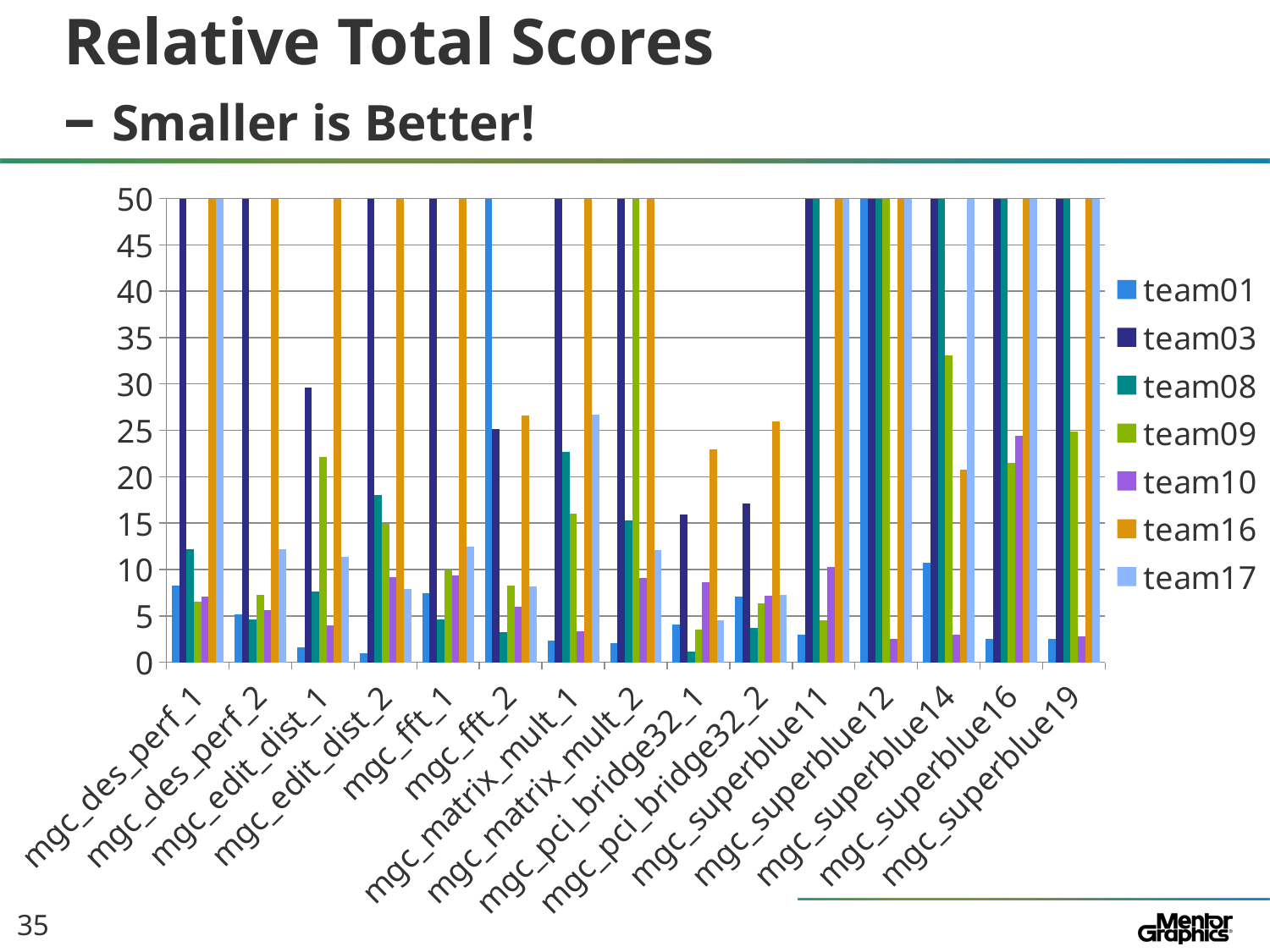
What is the title of the chart on the slide? Relative Total Scores – Smaller is Better! For mgc_pci_bridge32_1, which team has the highest value? team16 Is the value for team09 on mgc_superblue14 greater or less than 30? greater For mgc_edit_dist_1, which team has the lowest value? team01 Is the value for team03 on mgc_edit_dist_1 greater or less than 25? greater Is the value for team16 on mgc_pci_bridge32_1 greater or less than 20? greater For mgc_edit_dist_1, which is larger: team03 or team09? team03 How many benchmark categories are shown on the x axis? 15 How many series does the legend list? 7 What kind of chart is shown on the slide? bar chart